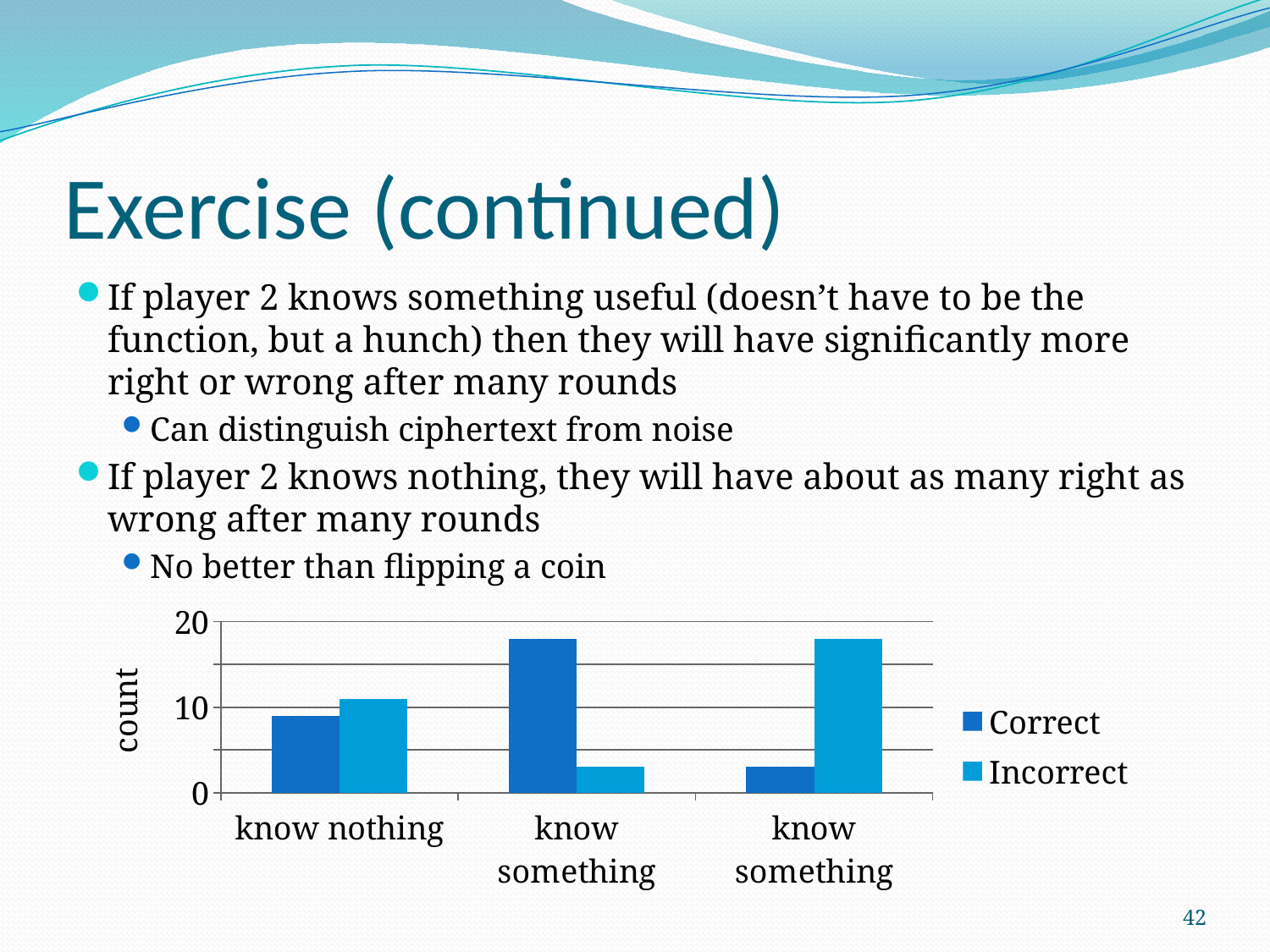
How many series does the chart's legend list? 2 What are the two series named in the chart's legend? Correct and Incorrect Which category has the highest Correct value? the middle "know something" category What is the label on the chart's vertical axis? count In the middle category (the first "know something"), which series has the larger value, Correct or Incorrect? Correct Is the Incorrect value for the middle category (the first "know something") greater or less than 10? less Is the Incorrect value for the rightmost category (the second "know something") greater or less than 10? greater What kind of chart is shown on the slide? bar chart In the rightmost category (the second "know something"), which series has the larger value, Correct or Incorrect? Incorrect Is the Correct value for the middle category (the first "know something") greater or less than 10? greater How many categories are shown along the x axis of the chart? 3